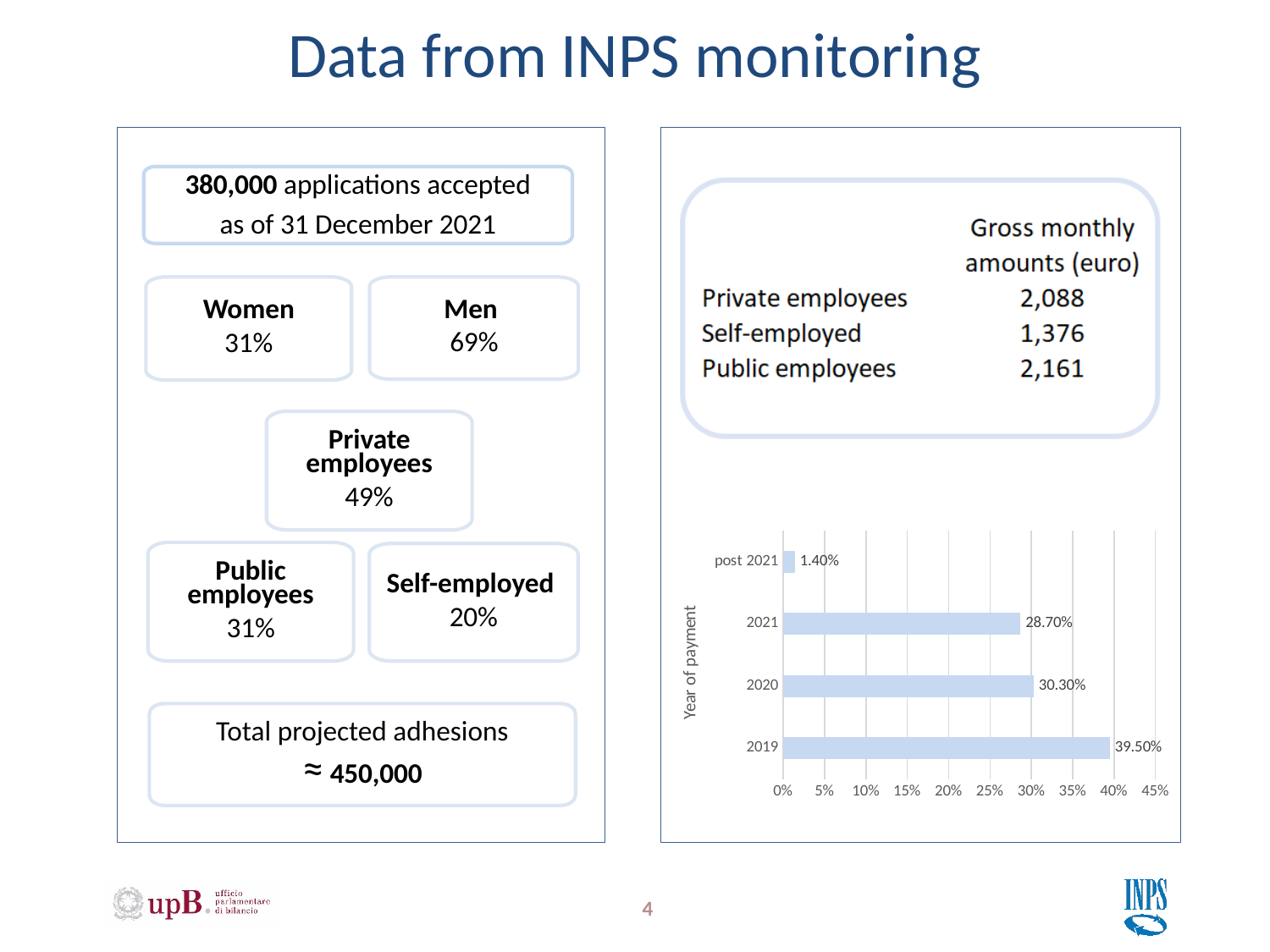
What is the value for post 2021 in the bar chart? 1.40% What is the difference between the values for 2019 and 2020 in the bar chart? 9.20% What is the value for 2020 in the bar chart? 30.30% Which is larger in the bar chart, the value for 2020 or the value for 2021? 2020 What is the value for 2019 in the bar chart? 39.50% Which year of payment has the lowest value in the bar chart? post 2021 What is the label on the vertical axis of the bar chart? Year of payment How many year-of-payment categories are shown in the bar chart? 4 Is the value for 2019 in the bar chart greater or less than 35%? greater Which year of payment has the highest value in the bar chart? 2019 What is the value for 2021 in the bar chart? 28.70% What kind of chart is shown on the slide? bar chart